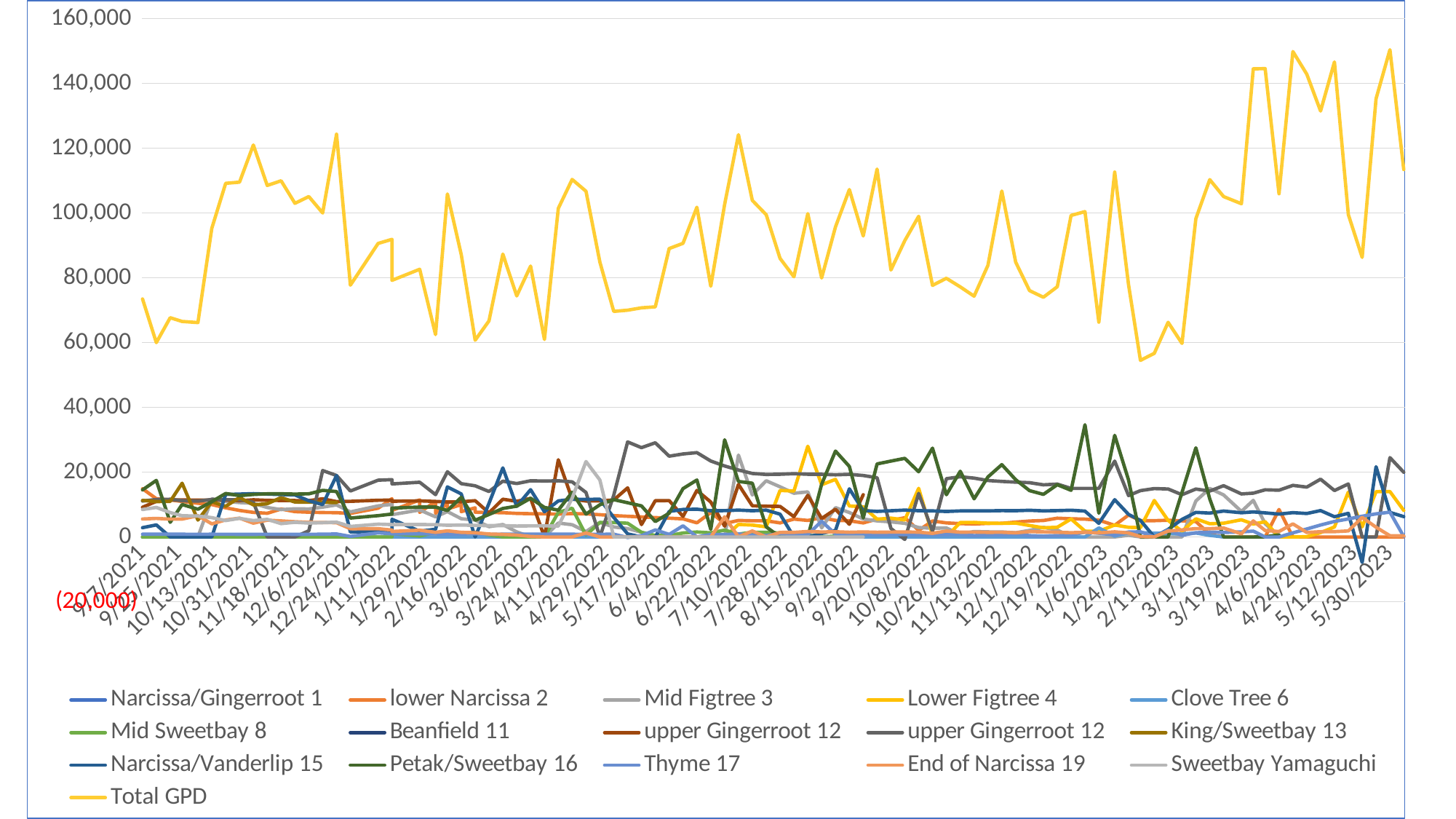
Is the highest point of the Total GPD line greater or less than 140,000? greater Is the Total GPD value at the first date, 9/7/2021, greater or less than 60,000? greater Which legend entry appears twice? upper Gingerroot 12 How many series does the legend list? 16 What is the highest value shown on the vertical axis? 160,000 What kind of chart is shown on the slide? line chart Does the Total GPD line ever exceed 160,000? No Does the Total GPD line generally rise or fall between 2/11/2023 and 4/6/2023? rise Which of the two is larger at 9/7/2021: Total GPD or Petak/Sweetbay 16? Total GPD Which series has the highest values throughout the chart? Total GPD